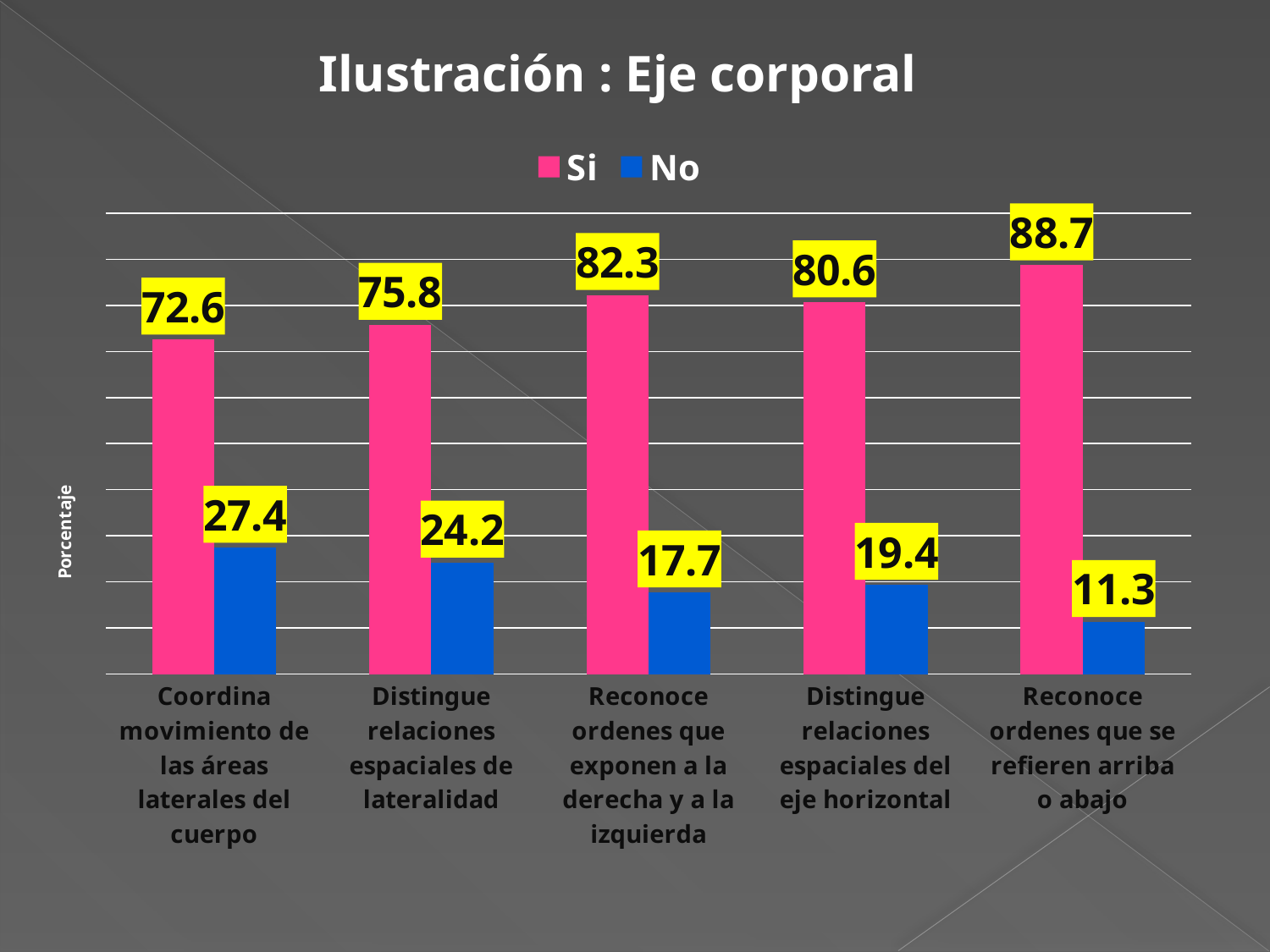
Which category has the lowest 'No' value? Reconoce ordenes que se refieren arriba o abajo What is the 'Si' value for 'Distingue relaciones espaciales del eje horizontal'? 80.6 Which is larger, the 'No' value for 'Distingue relaciones espaciales de lateralidad' or the 'No' value for 'Distingue relaciones espaciales del eje horizontal'? Distingue relaciones espaciales de lateralidad How many categories are shown on the x axis? 5 Which category has the highest 'Si' value? Reconoce ordenes que se refieren arriba o abajo How many series does the legend list? 2 What type of chart is shown on the slide? Bar chart What is the difference between the 'Si' and 'No' values for 'Distingue relaciones espaciales de lateralidad'? 51.6 What is the 'No' value for 'Coordina movimiento de las áreas laterales del cuerpo'? 27.4 What is the 'Si' value for 'Reconoce ordenes que se refieren arriba o abajo'? 88.7 What is the 'No' value for 'Reconoce ordenes que exponen a la derecha y a la izquierda'? 17.7 Which category has the lowest 'Si' value? Coordina movimiento de las áreas laterales del cuerpo